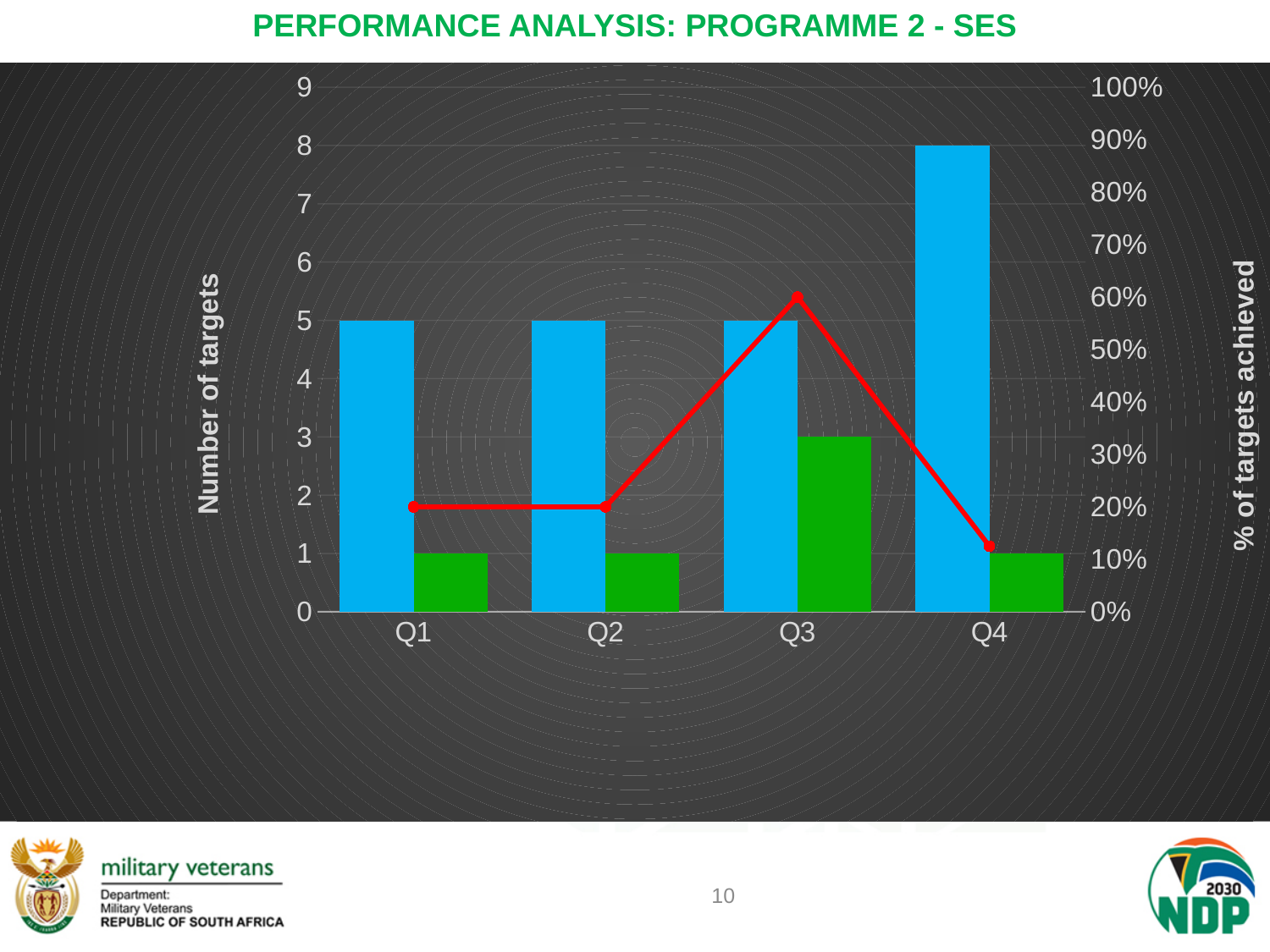
What is the value of the blue bar for Q4? 8 In Q3, which is larger, the blue bar or the green bar? the blue bar How many quarters are shown on the x axis? 4 What is the difference between the blue bar for Q4 and the blue bar for Q1? 3 Which quarter has the highest blue bar? Q4 Which quarter has the highest green bar? Q3 What kind of chart is shown on the slide? bar chart with a line What is the value of the green bar for Q3? 3 Is the value of the red line for Q4 greater or less than 20%? less What is the title of the right-hand vertical axis? % of targets achieved Does the red line rise or fall from Q3 to Q4? fall What percentage does the red line show for Q3? 60%